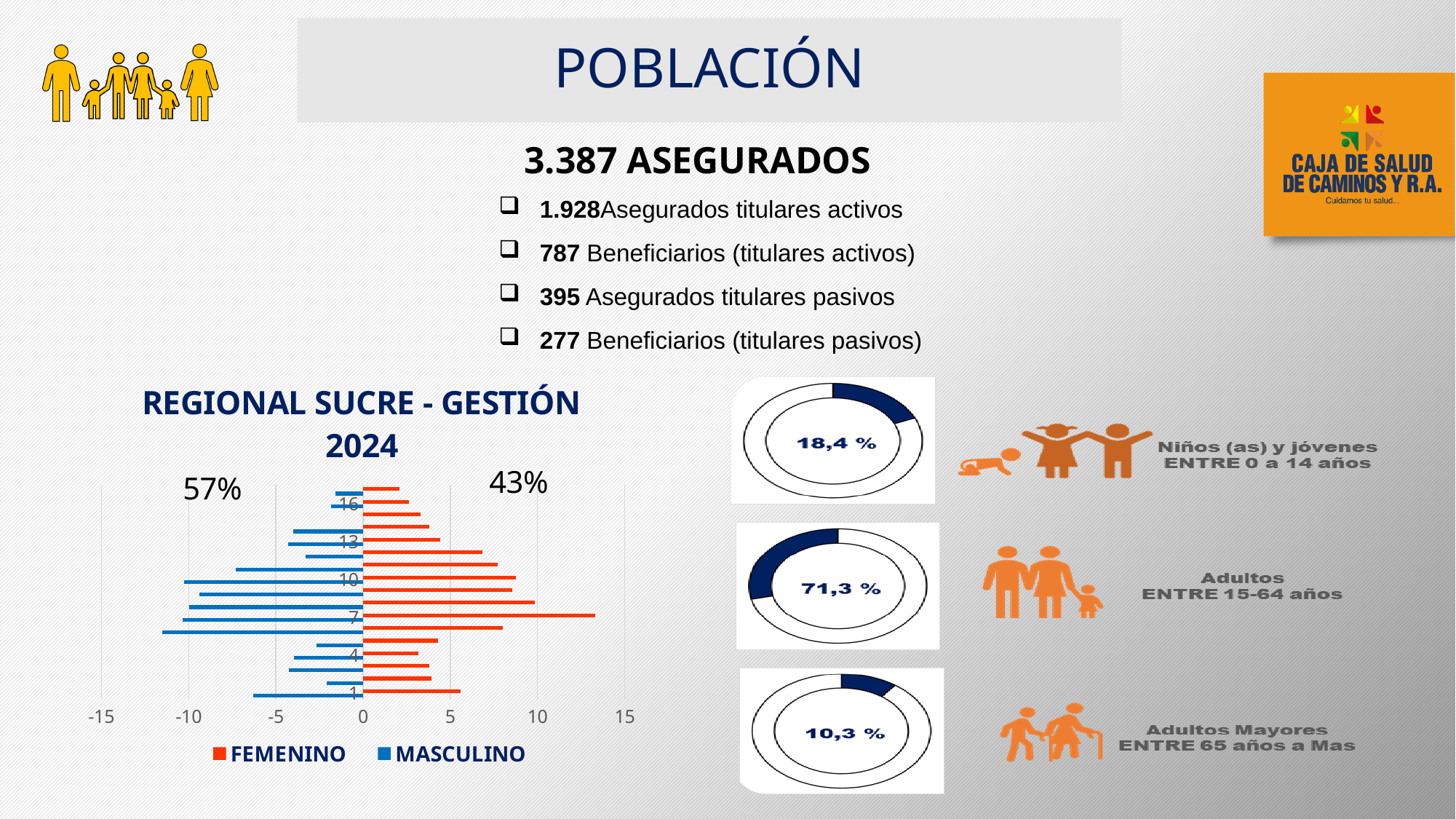
In the donut charts, what percentage is shown for 'Niños (as) y jóvenes ENTRE 0 a 14 años'? 18,4 % How many donut charts are shown on the right side of the slide? 3 Among the three donut charts, which age group has the lowest percentage? Adultos Mayores ENTRE 65 años a Mas How many series does the legend of the 'REGIONAL SUCRE - GESTIÓN 2024' chart list? 2 In the donut charts, what percentage is shown for 'Adultos Mayores ENTRE 65 años a Mas'? 10,3 % In the 'REGIONAL SUCRE - GESTIÓN 2024' chart, is the FEMENINO value at category 7 greater or less than 10? greater In the 'REGIONAL SUCRE - GESTIÓN 2024' chart, what percentage label is shown above the MASCULINO (left) side of the pyramid? 57% In the donut charts, what is the difference between the percentage for 'Adultos ENTRE 15-64 años' and the percentage for 'Niños (as) y jóvenes ENTRE 0 a 14 años'? 52,9 % Among the three donut charts, which age group has the highest percentage? Adultos ENTRE 15-64 años What is the title of the bar chart on the left of the slide? REGIONAL SUCRE - GESTIÓN 2024 In the donut charts, what percentage is shown for 'Adultos ENTRE 15-64 años'? 71,3 % What kind of chart is the 'REGIONAL SUCRE - GESTIÓN 2024' chart? bar chart